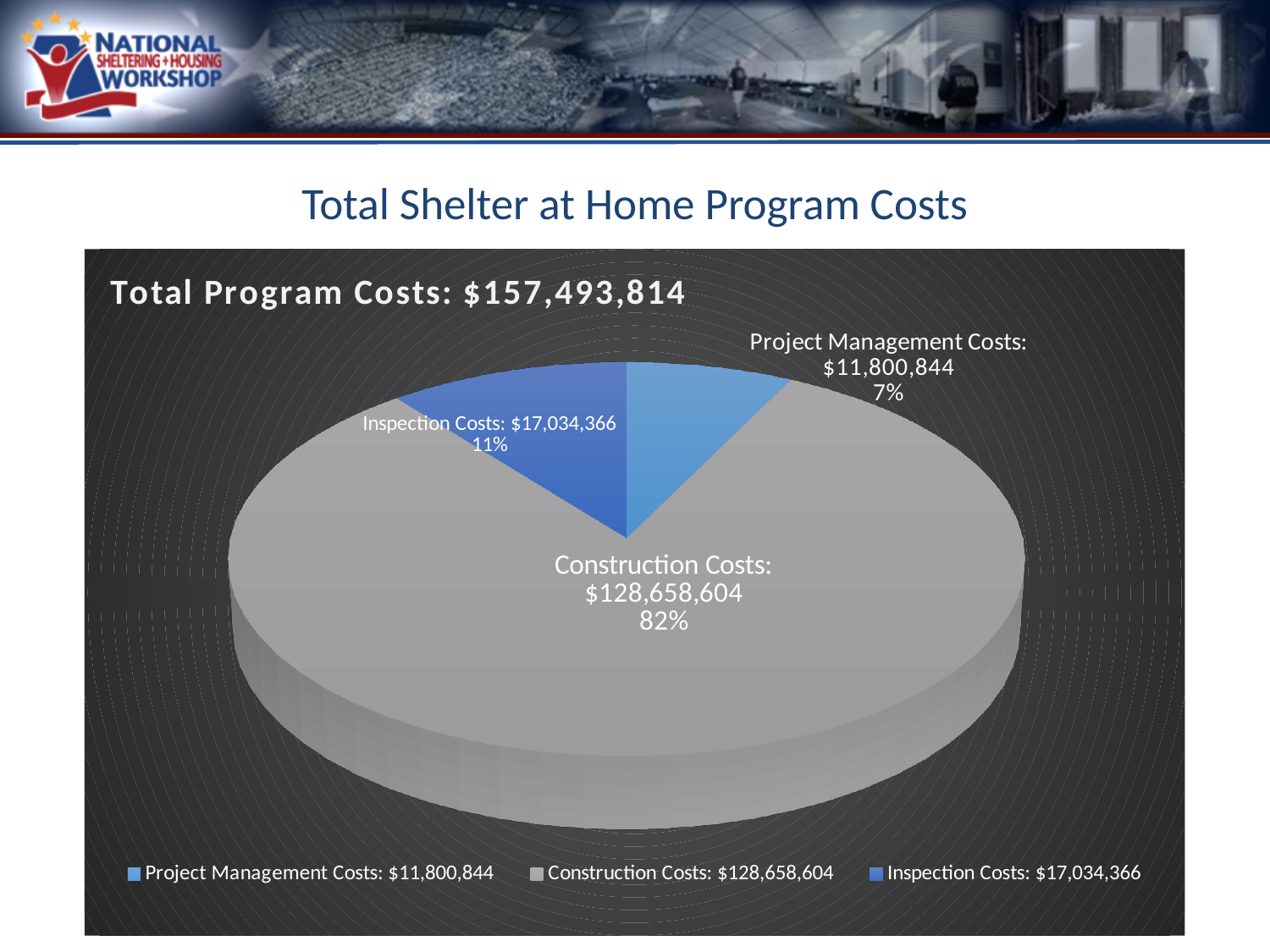
Which category has the smallest slice of the pie? Project Management Costs What share of the pie is Inspection Costs? 11% What is the value of Project Management Costs? $11,800,844 What is the value of Construction Costs? $128,658,604 What share of the pie is Construction Costs? 82% What share of the pie is Project Management Costs? 7% Which is larger, Inspection Costs or Project Management Costs? Inspection Costs What is the chart's title? Total Program Costs: $157,493,814 How many slices does the pie chart have? 3 Which category has the largest slice of the pie? Construction Costs What is the value of Inspection Costs? $17,034,366 What type of chart is shown on the slide? Pie chart